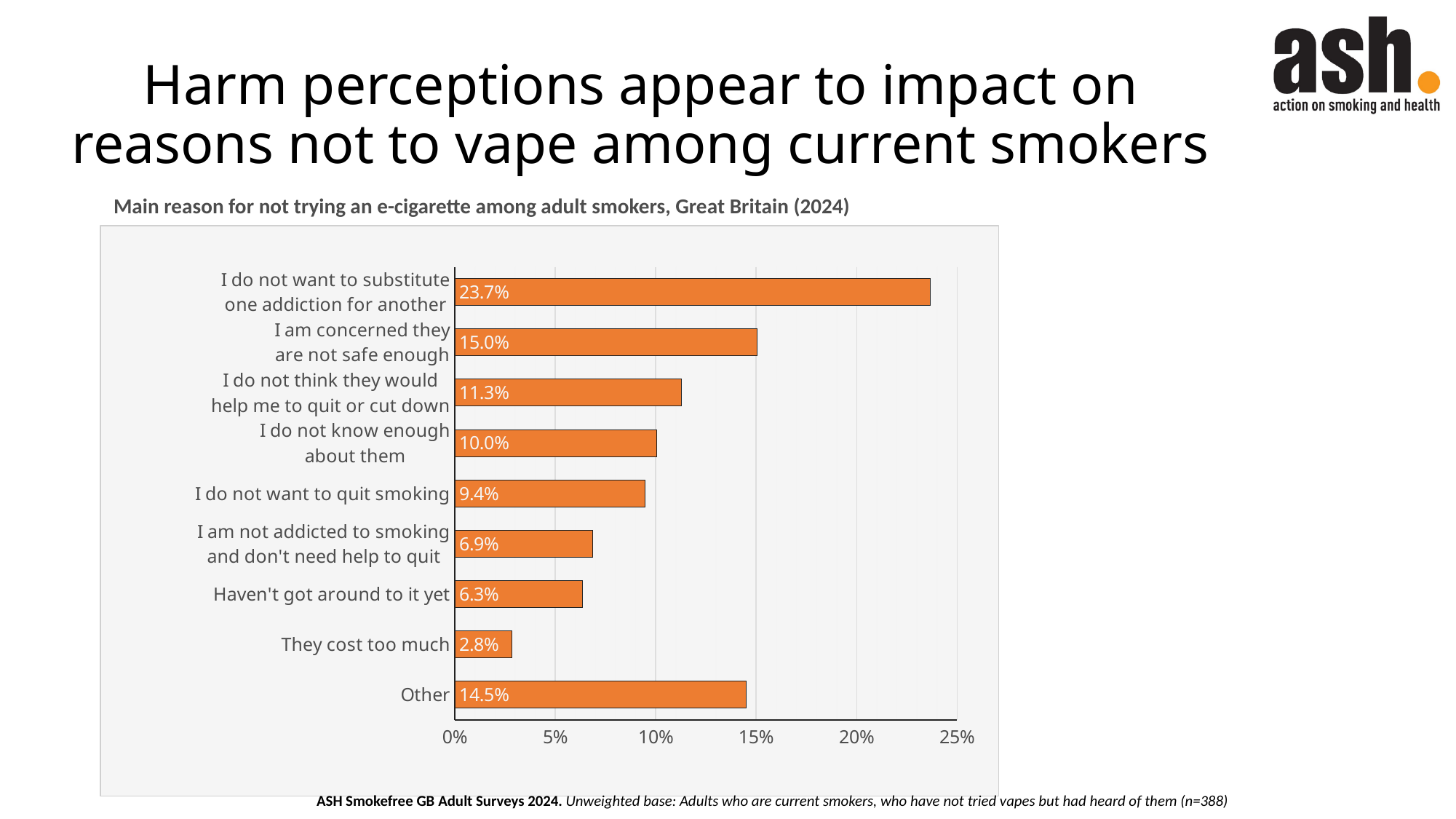
Which reason has the highest percentage? I do not want to substitute one addiction for another What kind of chart is shown on the slide? Bar chart What is the title of the chart? Main reason for not trying an e-cigarette among adult smokers, Great Britain (2024) What is the difference between "I am concerned they are not safe enough" and "I do not know enough about them"? 5.0% Which reason has the lowest percentage? They cost too much Is the value for "I do not think they would help me to quit or cut down" greater or less than 10%? greater Which is larger: "I do not want to quit smoking" or "Haven't got around to it yet"? I do not want to quit smoking What is the value for "Other"? 14.5% What percentage of adult smokers gave "I do not want to substitute one addiction for another" as their main reason for not trying an e-cigarette? 23.7% What is the value for "They cost too much"? 2.8% How many reasons (categories) are shown in the chart? 9 What is the value for "I am concerned they are not safe enough"? 15.0%